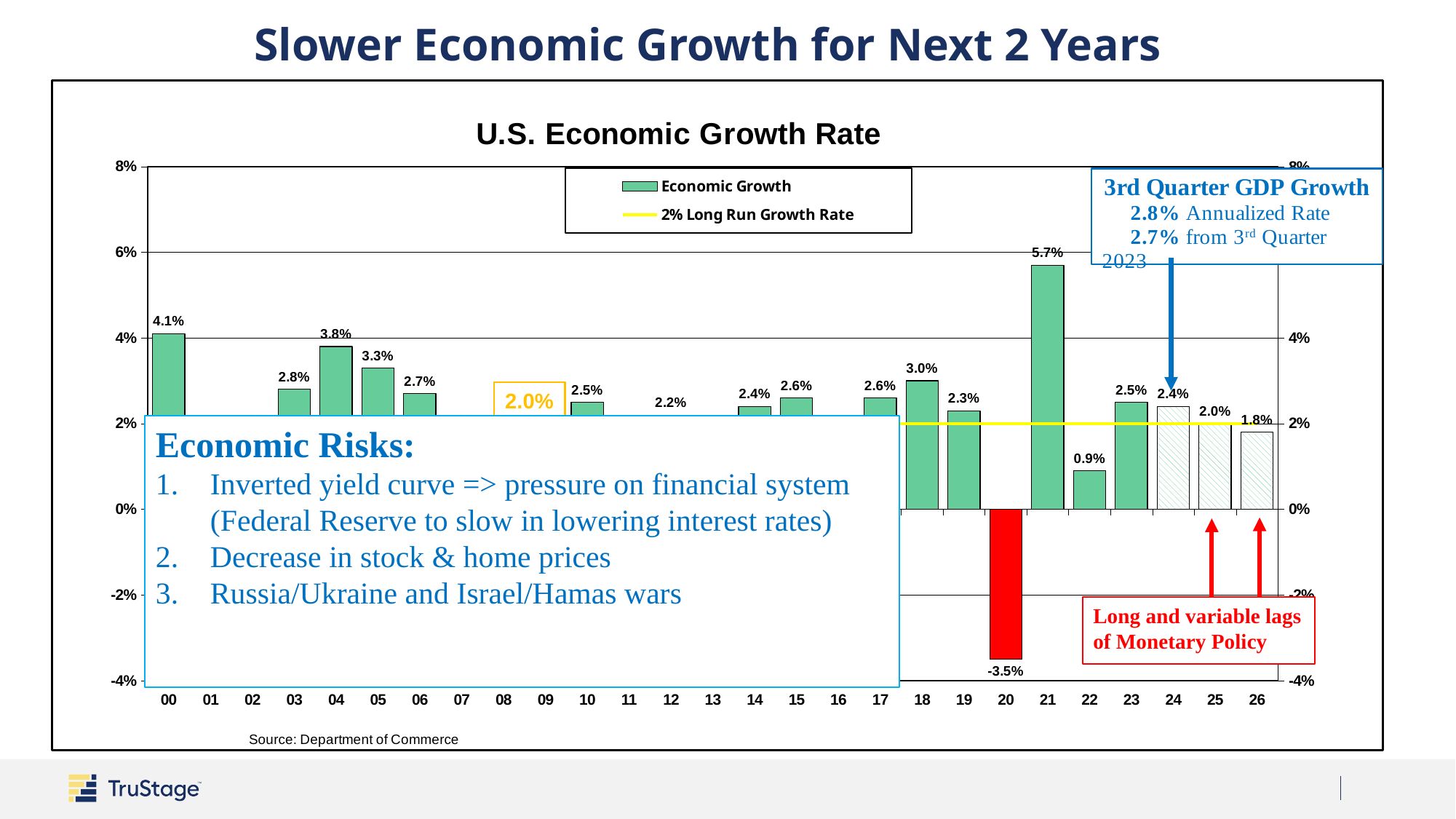
Which year has the lowest economic growth rate on the chart? 20 What is the U.S. economic growth rate shown for 21? 5.7% Which year has the highest economic growth rate on the chart? 21 What is the difference between the growth rates for 21 and 18? 2.7 percentage points What is the growth rate shown for 26? 1.8% Do the growth rates rise or fall from 24 to 26? Fall Which year has the larger growth rate, 04 or 05? 04 What is the growth rate shown for 22? 0.9% How many series does the legend list? 2 What is the U.S. economic growth rate shown for 20? -3.5% What kind of chart is used to show the U.S. Economic Growth Rate? Bar chart What is the label of the yellow line in the legend? 2% Long Run Growth Rate